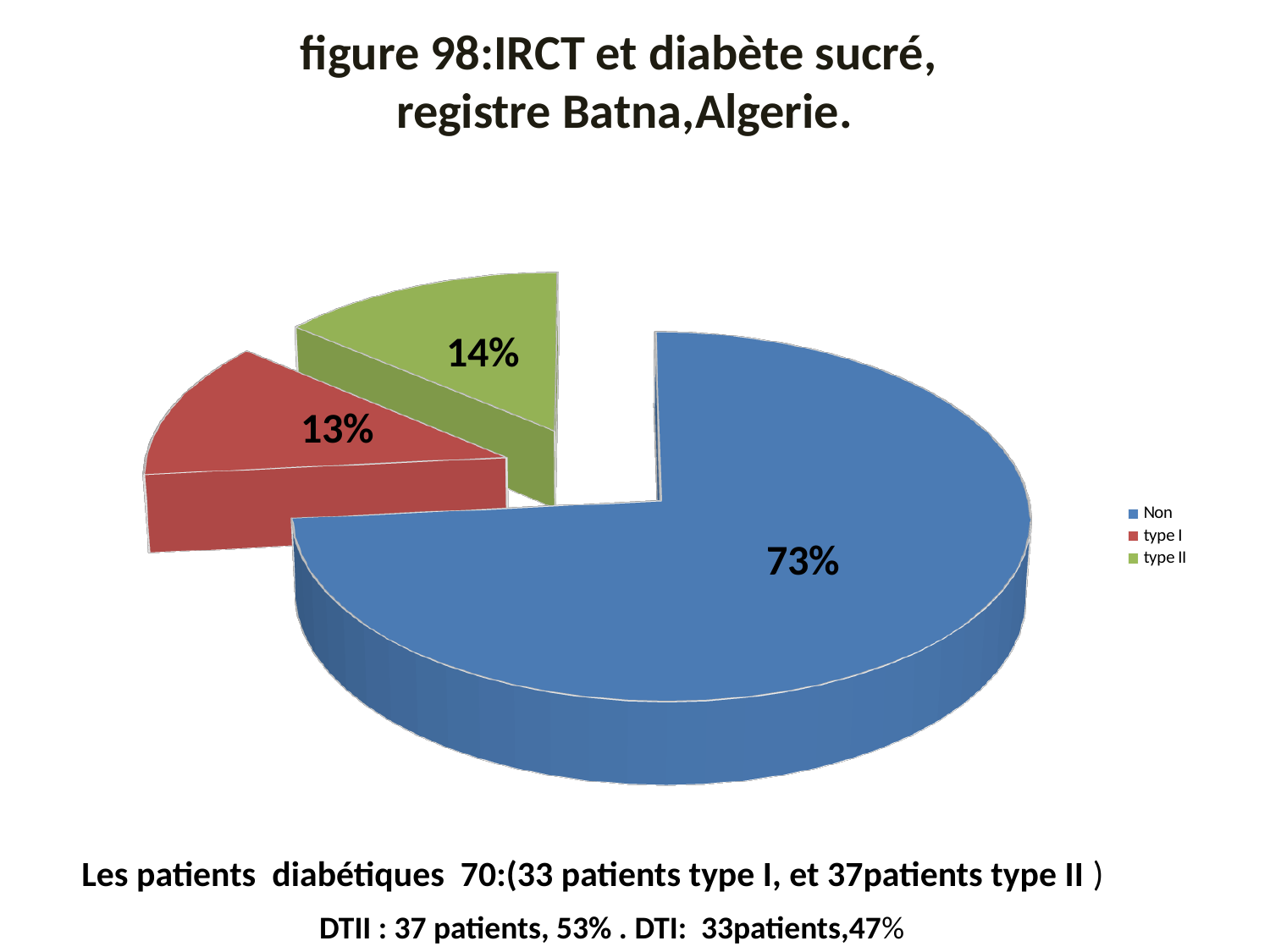
What is the difference in percentage points between the 'Non' slice and the 'type II' slice? 59 What percentage is shown for 'type I'? 13% Which is larger, the 'type II' slice or the 'type I' slice? type II What percentage is shown for 'type II'? 14% Which category has the smallest slice of the pie? type I What is the difference in percentage points between 'type II' and 'type I'? 1 What share of the pie does the 'Non' slice represent? 73% What is the title of the chart? figure 98:IRCT et diabète sucré, registre Batna,Algerie. What kind of chart is shown on the slide? Pie chart Which category has the largest slice of the pie? Non How many categories does the pie chart show? 3 What colour is the 'type II' slice in the pie chart? Green